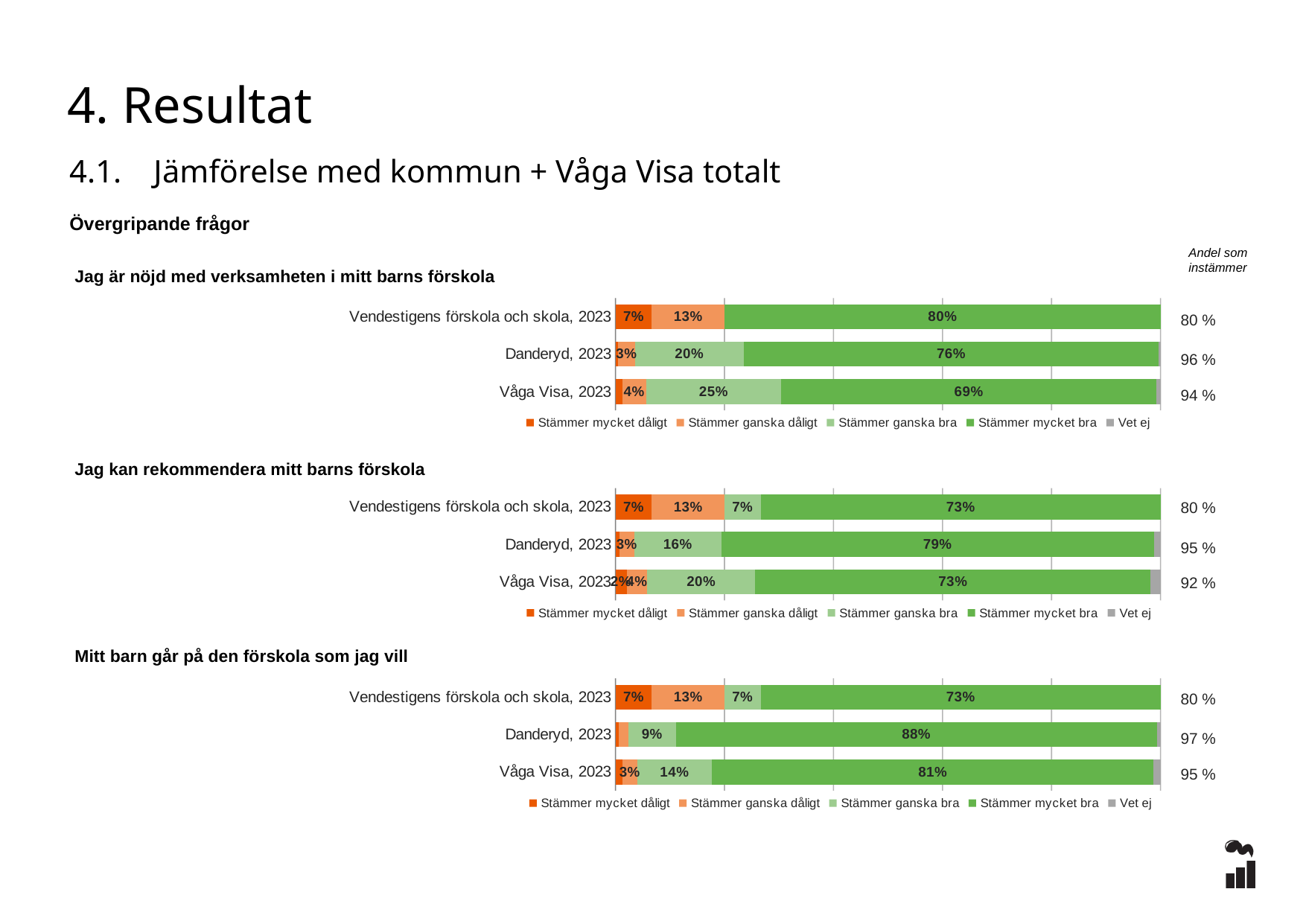
In the chart 'Jag är nöjd med verksamheten i mitt barns förskola', which row has the highest 'Stämmer mycket bra' value? Vendestigens förskola och skola, 2023 In the chart 'Mitt barn går på den förskola som jag vill', what is the 'Stämmer mycket bra' value for Danderyd, 2023? 88% In the chart 'Jag är nöjd med verksamheten i mitt barns förskola', what is the 'Stämmer ganska bra' value for Våga Visa, 2023? 25% In the chart 'Jag är nöjd med verksamheten i mitt barns förskola', what is the 'Stämmer mycket bra' value for Vendestigens förskola och skola, 2023? 80% In the chart 'Jag kan rekommendera mitt barns förskola', what is the 'Stämmer mycket bra' value for Danderyd, 2023? 79% How many series does the legend of the chart 'Jag kan rekommendera mitt barns förskola' list? 5 In the chart 'Mitt barn går på den förskola som jag vill', which row has the lowest 'Stämmer mycket bra' value? Vendestigens förskola och skola, 2023 In the chart 'Jag kan rekommendera mitt barns förskola', which is larger: the 'Stämmer ganska bra' value for Danderyd, 2023 or for Vendestigens förskola och skola, 2023? Danderyd, 2023 In the chart 'Jag kan rekommendera mitt barns förskola', what is the 'Stämmer ganska bra' value for Våga Visa, 2023? 20% In the chart 'Mitt barn går på den förskola som jag vill', what is the difference between the 'Stämmer mycket bra' values for Danderyd, 2023 and Våga Visa, 2023? 7% In the chart 'Jag är nöjd med verksamheten i mitt barns förskola', what is the difference between the 'Stämmer mycket bra' values for Danderyd, 2023 and Våga Visa, 2023? 7% What kind of chart is 'Mitt barn går på den förskola som jag vill'? Stacked bar chart